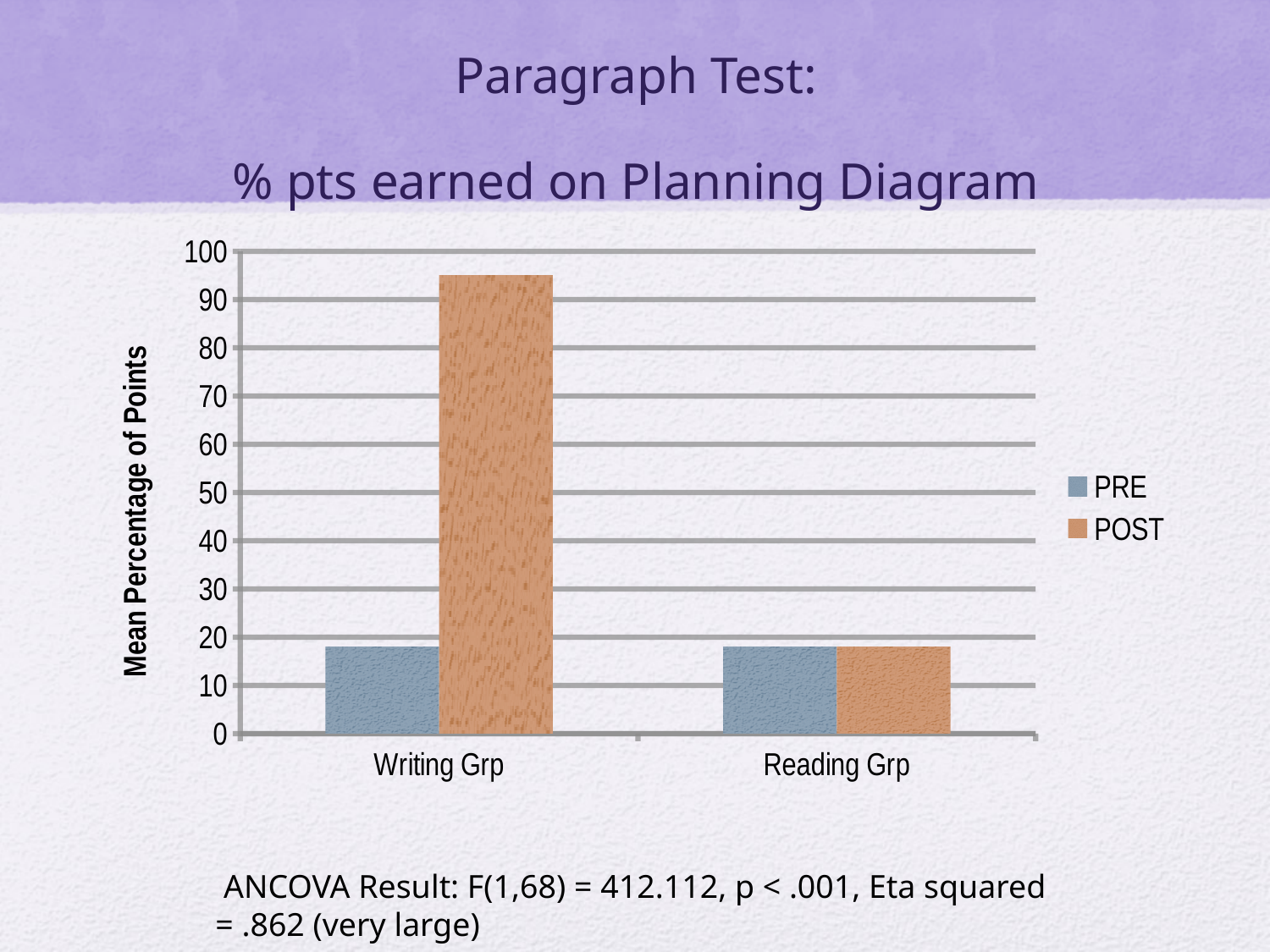
What are the two series named in the legend? PRE and POST Is the PRE value for Reading Grp greater or less than 10? greater How many series does the legend list? 2 Which is larger, the POST value for Writing Grp or the POST value for Reading Grp? Writing Grp Is the PRE value for Writing Grp greater or less than 20? less Is the POST value for Writing Grp greater or less than 90? greater For Writing Grp, which is larger, the PRE value or the POST value? POST How many groups are shown on the x axis? 2 Which bar is the highest in the chart? POST for Writing Grp What is the label on the vertical axis of the chart? Mean Percentage of Points What kind of chart is shown on the slide? bar chart